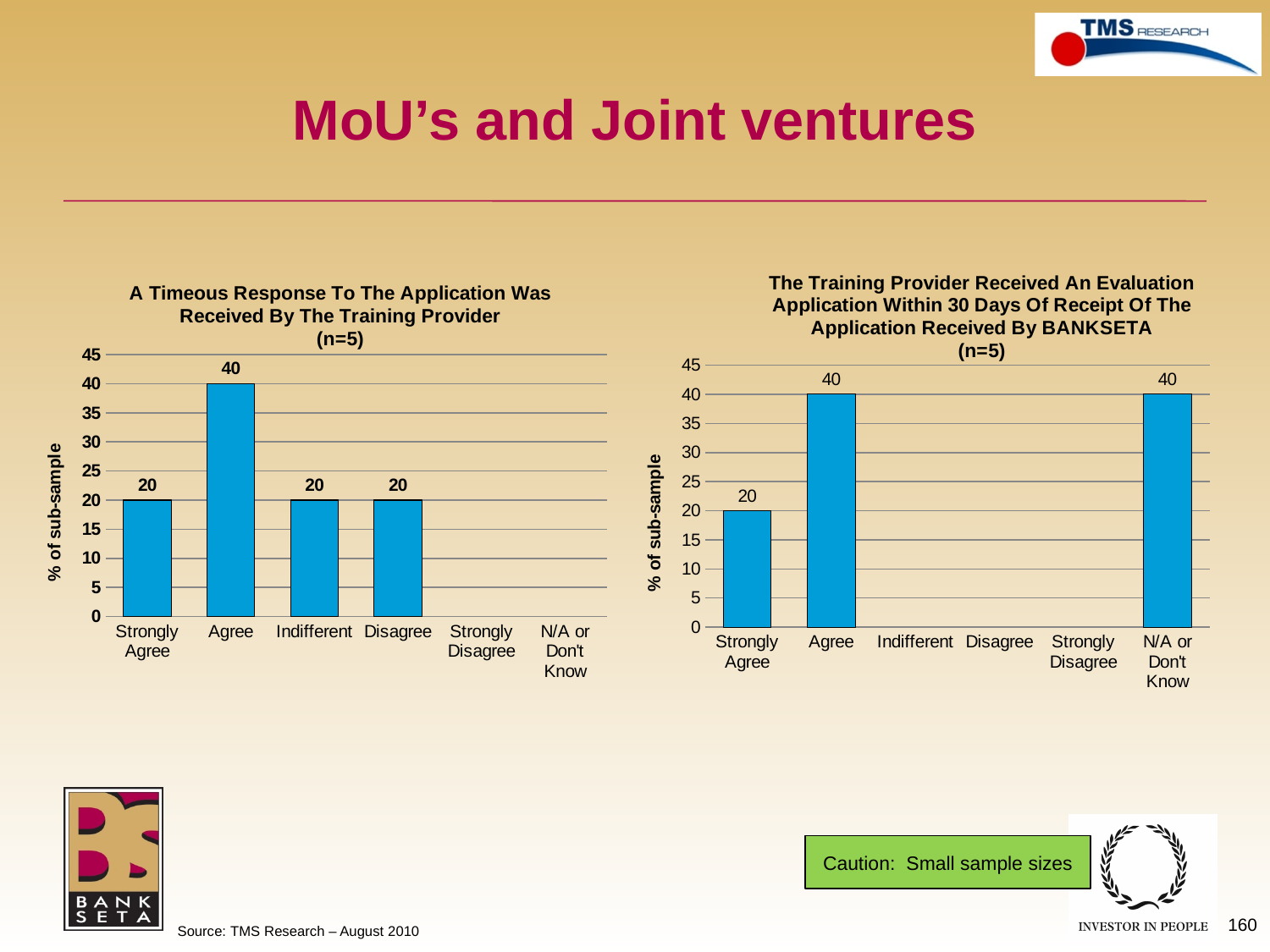
In the left chart 'A Timeous Response To The Application Was Received By The Training Provider', what is the y-axis label? % of sub-sample In the right chart 'The Training Provider Received An Evaluation Application Within 30 Days Of Receipt Of The Application Received By BANKSETA', what is the difference between the values for Agree and Strongly Agree? 20 In the left chart 'A Timeous Response To The Application Was Received By The Training Provider', what is the value for Agree? 40 In the left chart 'A Timeous Response To The Application Was Received By The Training Provider', how many categories are shown on the x axis? 6 In the right chart 'The Training Provider Received An Evaluation Application Within 30 Days Of Receipt Of The Application Received By BANKSETA', what sample size is given in the title? n=5 In the right chart 'The Training Provider Received An Evaluation Application Within 30 Days Of Receipt Of The Application Received By BANKSETA', which is larger, the value for Agree or the value for Strongly Agree? Agree What kind of chart is the right chart 'The Training Provider Received An Evaluation Application Within 30 Days Of Receipt Of The Application Received By BANKSETA'? Bar chart In the right chart 'The Training Provider Received An Evaluation Application Within 30 Days Of Receipt Of The Application Received By BANKSETA', what is the value for N/A or Don't Know? 40 In the left chart 'A Timeous Response To The Application Was Received By The Training Provider', which category has the highest value? Agree In the left chart 'A Timeous Response To The Application Was Received By The Training Provider', what is the value for Indifferent? 20 In the right chart 'The Training Provider Received An Evaluation Application Within 30 Days Of Receipt Of The Application Received By BANKSETA', what is the value for Strongly Agree? 20 In the left chart 'A Timeous Response To The Application Was Received By The Training Provider', what is the difference between the values for Agree and Disagree? 20